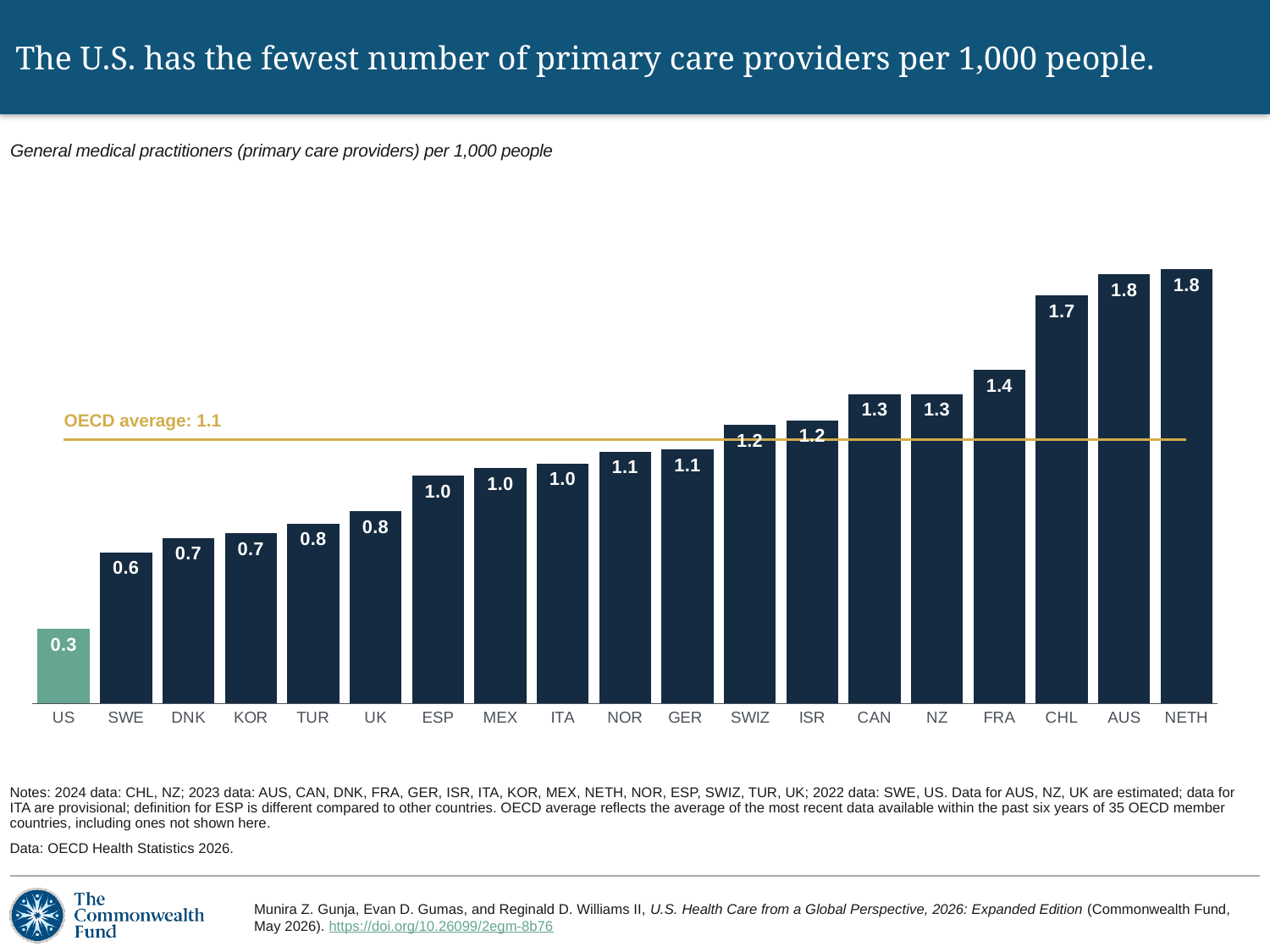
What OECD average value is marked by the horizontal line on the chart? 1.1 Which is larger, the value for CHL or the value for FRA? CHL What is the value for CHL? 1.7 How many countries are shown in the chart? 19 What is the difference between the values for CAN and TUR? 0.5 What kind of chart is shown on the slide? Bar chart What is the difference between the values for NETH and US? 1.5 Which country has the lowest number of general medical practitioners per 1,000 people? US What is the value for the US? 0.3 What is the value for FRA? 1.4 What is the value for SWE? 0.6 Which is larger, the value for UK or the value for ESP? ESP